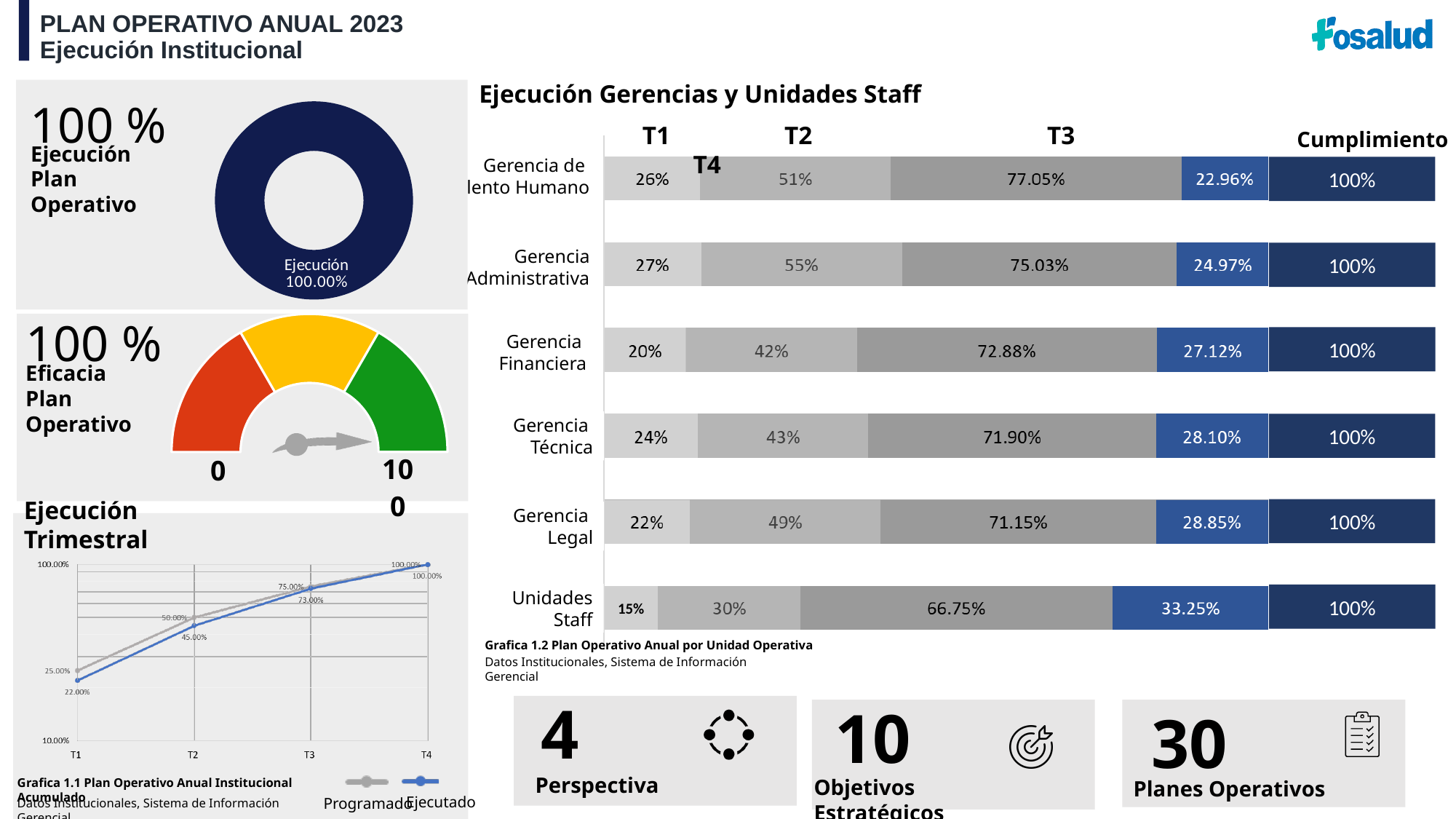
What kind of chart is the Ejecución Gerencias y Unidades Staff chart? bar chart In the Ejecución Trimestral chart, what is the difference between the Programado and Ejecutado values at T1? 3.00% In the Ejecución Gerencias y Unidades Staff chart, which category has the lowest T1 value? Unidades Staff In the Ejecución Trimestral line chart, what is the Programado value at T3? 75.00% In the Ejecución Gerencias y Unidades Staff chart, which category has the highest T4 value? Unidades Staff In the Ejecución Gerencias y Unidades Staff chart, what is the T4 value for Unidades Staff? 33.25% How many categories are shown in the Ejecución Gerencias y Unidades Staff chart? 6 In the Ejecución Gerencias y Unidades Staff chart, what is the T3 value for Gerencia Financiera? 72.88% In the Ejecución Trimestral line chart, what is the Ejecutado value at T2? 45.00% How many series does the legend of the Ejecución Trimestral chart list? 2 In the Ejecución Trimestral chart, do the Ejecutado values rise or fall from T1 to T4? rise In the Ejecución Gerencias y Unidades Staff chart, which has the larger T2 value: Gerencia Administrativa or Gerencia Legal? Gerencia Administrativa